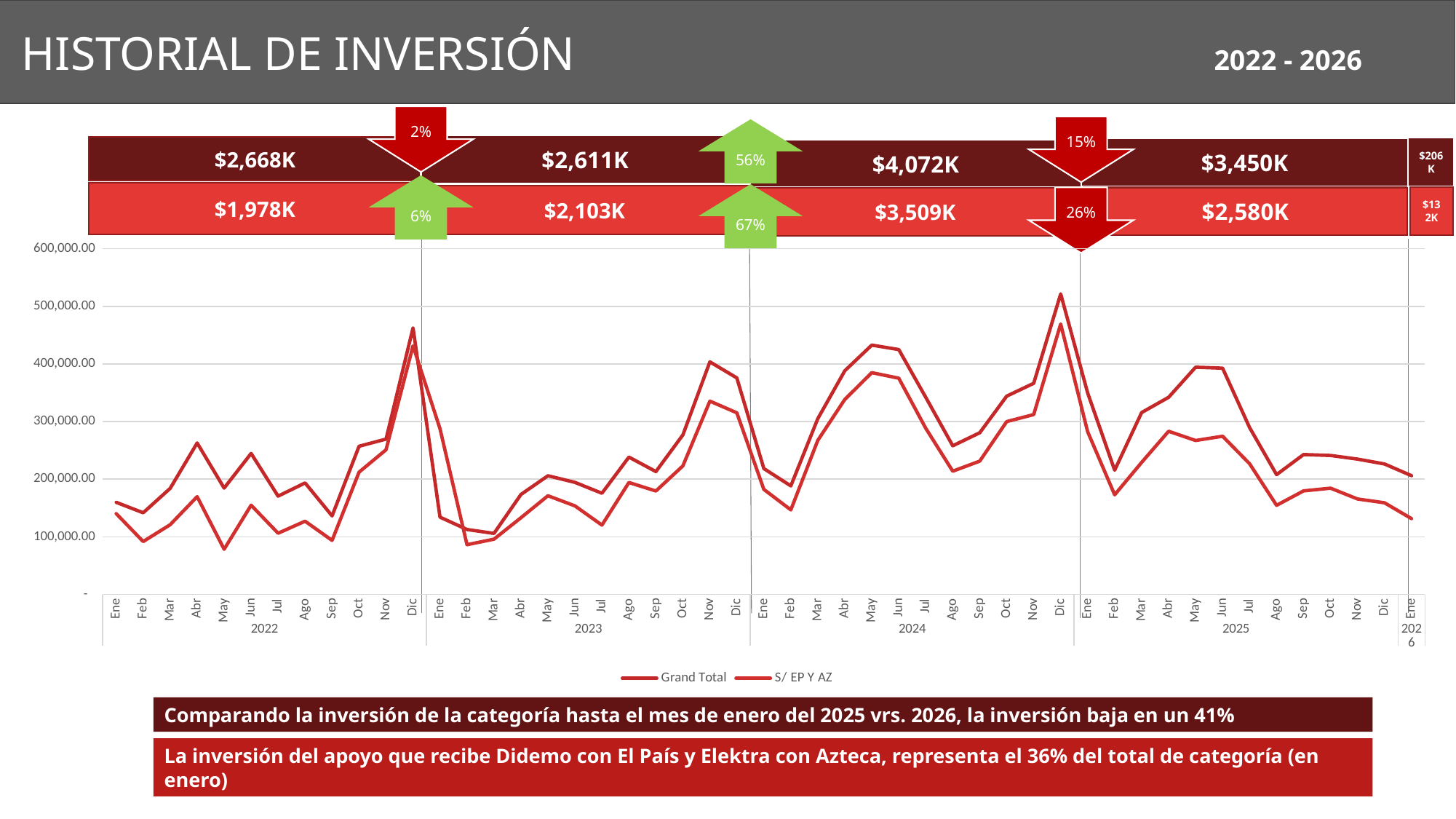
How many years are labelled along the x axis of the chart? 5 What kind of chart is shown on the slide? line chart Is the Grand Total value for Dic 2022 greater or less than 400,000.00? greater Is the S/ EP Y AZ value for Feb 2023 greater or less than 100,000.00? less Is the Grand Total value for Ene 2026 greater or less than 300,000.00? less In May 2024, which series has the higher value, Grand Total or S/ EP Y AZ? Grand Total Does the Grand Total line rise or fall from Dic 2025 to Ene 2026? fall What are the two series named in the chart legend? Grand Total and S/ EP Y AZ What is the highest value shown on the chart's y axis? 600,000.00 What is the annual Grand Total investment shown for 2024 in the dark bar above the chart? $4,072K In which month and year does the Grand Total line reach its highest point? Dic 2024 How many series does the chart legend list? 2